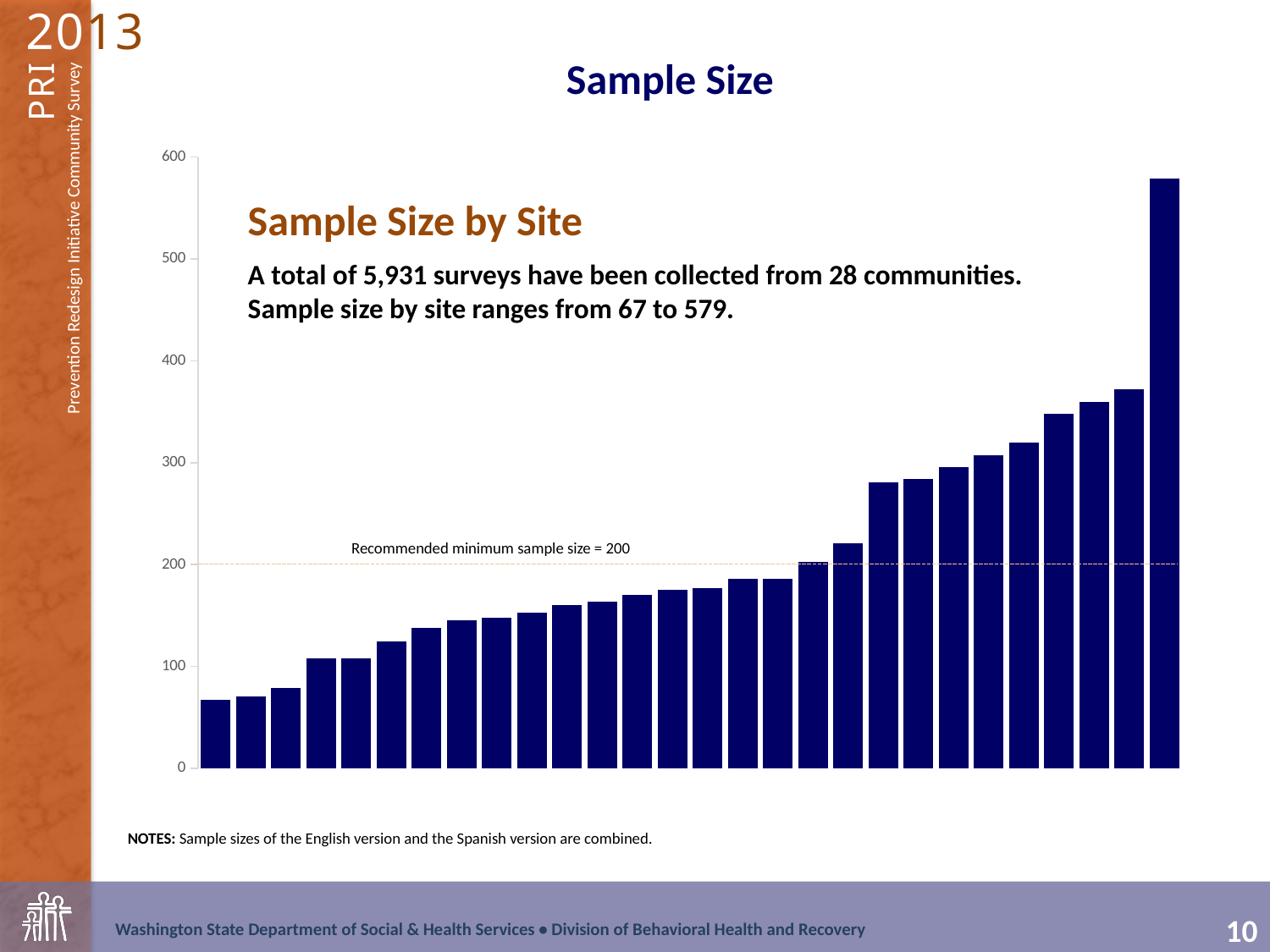
What kind of chart is shown on the slide? bar chart What is the largest sample size for a single site, according to the slide? 579 Which bar is larger, the leftmost bar or the rightmost bar? the rightmost bar Is the value of the second-tallest bar greater or less than 400? less What is the smallest sample size for a single site, according to the slide? 67 Is the value of the leftmost bar greater or less than 100? less What is the title of the chart? Sample Size by Site Is the value of the rightmost (tallest) bar greater or less than 500? greater What is the total number of surveys collected across all sites? 5,931 How many bars (sites) are plotted in the chart? 28 What is the recommended minimum sample size marked by the dashed line on the chart? 200 Do the bar values rise or fall from left to right across the chart? rise